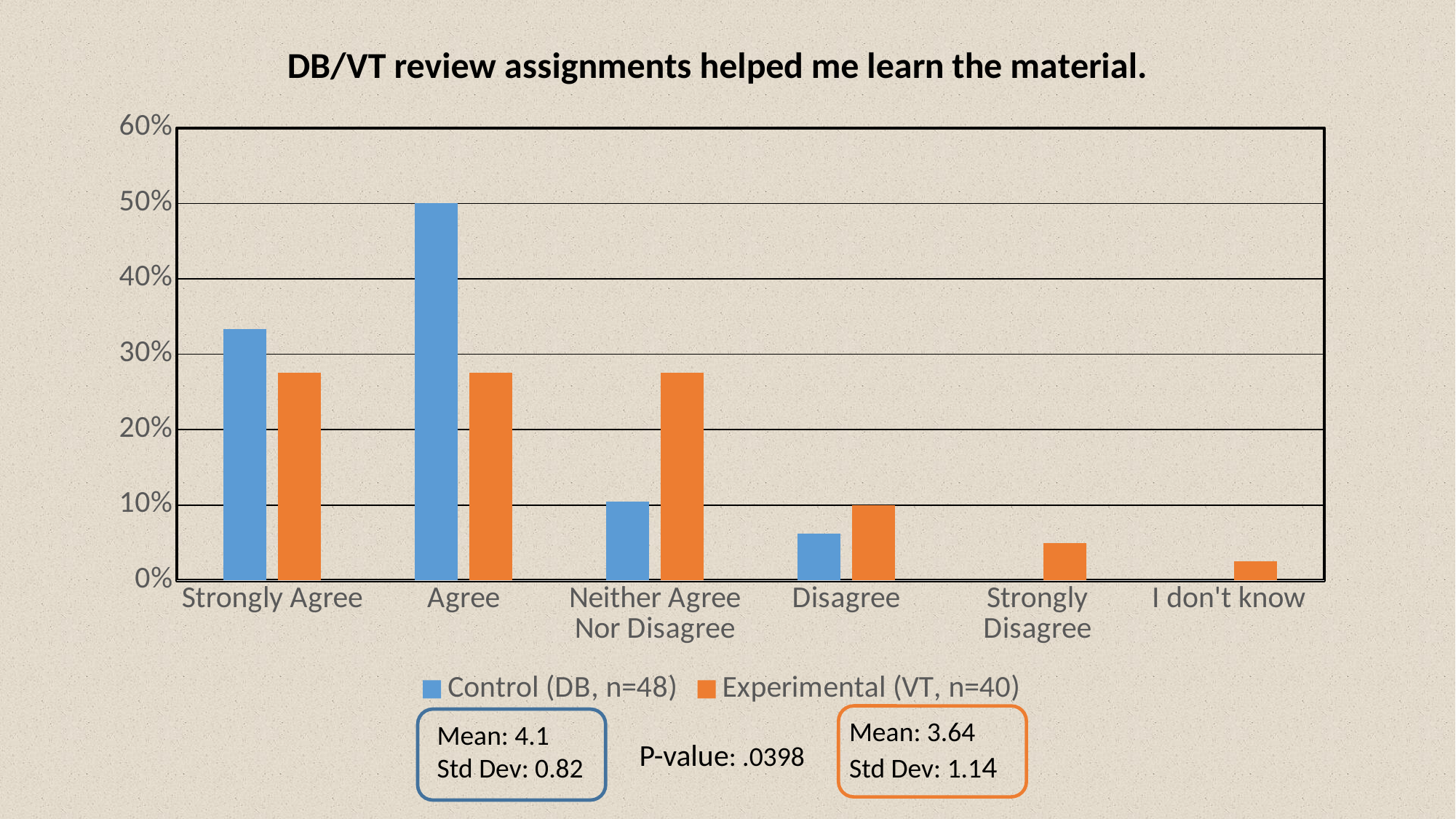
For Neither Agree Nor Disagree, which series has the larger value, Control (DB, n=48) or Experimental (VT, n=40)? Experimental (VT, n=40) Is the value for Strongly Agree in the Control (DB, n=48) series greater or less than 30%? greater Is the value for Strongly Agree in the Experimental (VT, n=40) series greater or less than 30%? less Which category has the lowest non-zero value for the Experimental (VT, n=40) series? I don't know Is the value for Strongly Disagree in the Experimental (VT, n=40) series greater or less than 10%? less What is the sample size (n) given in the legend for the Experimental (VT) series? 40 How many series does the legend list? 2 What kind of chart is shown on the slide? bar chart What is the title of the chart? DB/VT review assignments helped me learn the material. For Strongly Agree, which series has the larger value, Control (DB, n=48) or Experimental (VT, n=40)? Control (DB, n=48) How many categories are shown on the x axis? 6 Which category has the highest value for the Control (DB, n=48) series? Agree